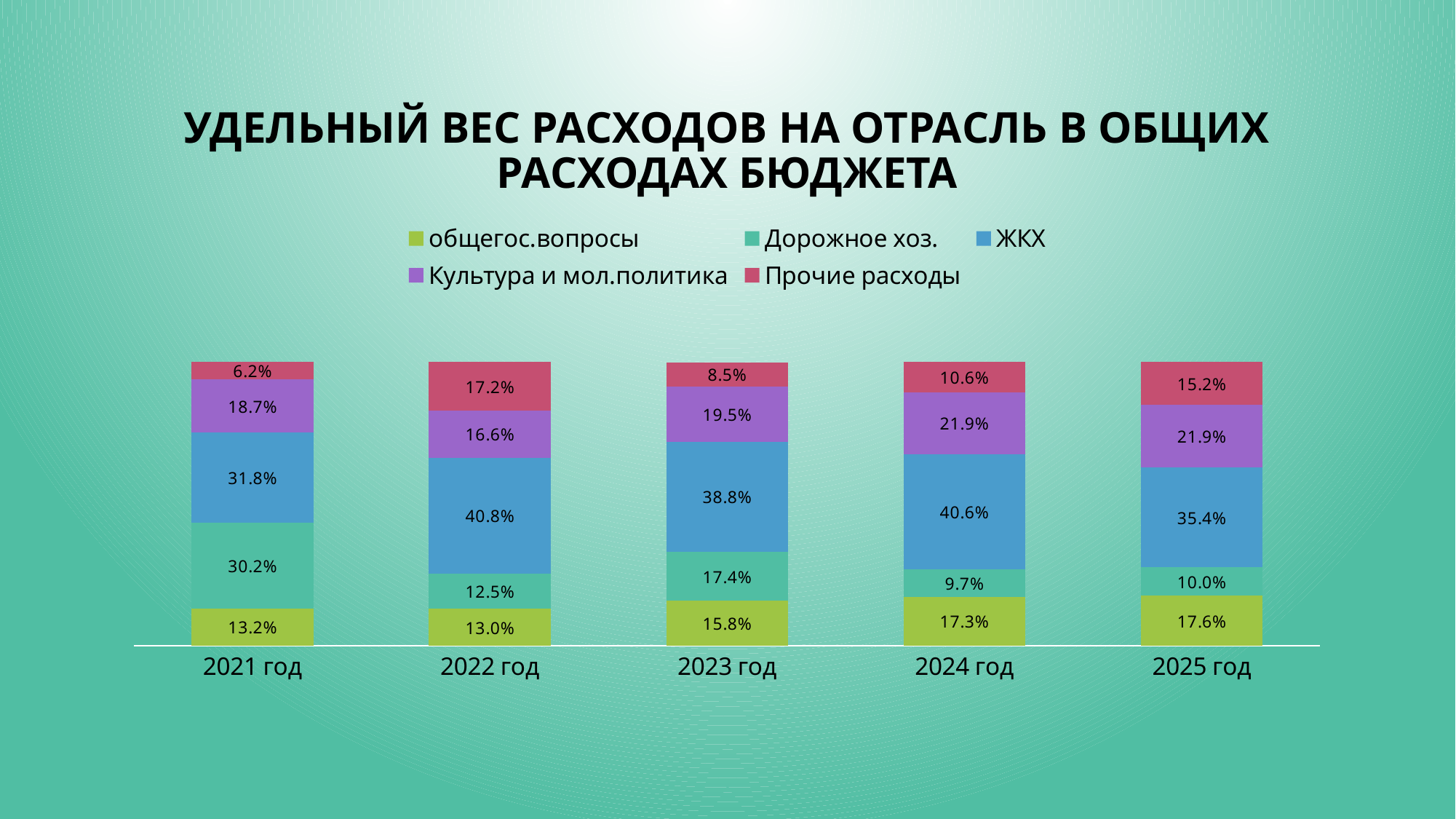
What is the difference between the value for Прочие расходы in 2022 год and in 2023 год? 8.7% What is the difference between the value for общегос.вопросы in 2025 год and in 2021 год? 4.4% What is the value for ЖКХ in 2022 год? 40.8% What is the value for Дорожное хоз. in 2021 год? 30.2% Does the value for общегос.вопросы rise or fall from 2022 год to 2025 год? Rise How many series does the legend list? 5 In which year is the value for Дорожное хоз. the lowest? 2024 год What is the value for Прочие расходы in 2021 год? 6.2% In which year is the value for ЖКХ the highest? 2022 год What kind of chart is shown on the slide? Stacked bar chart In 2023 год, which is larger: Культура и мол.политика or Прочие расходы? Культура и мол.политика How many years are shown on the x axis? 5